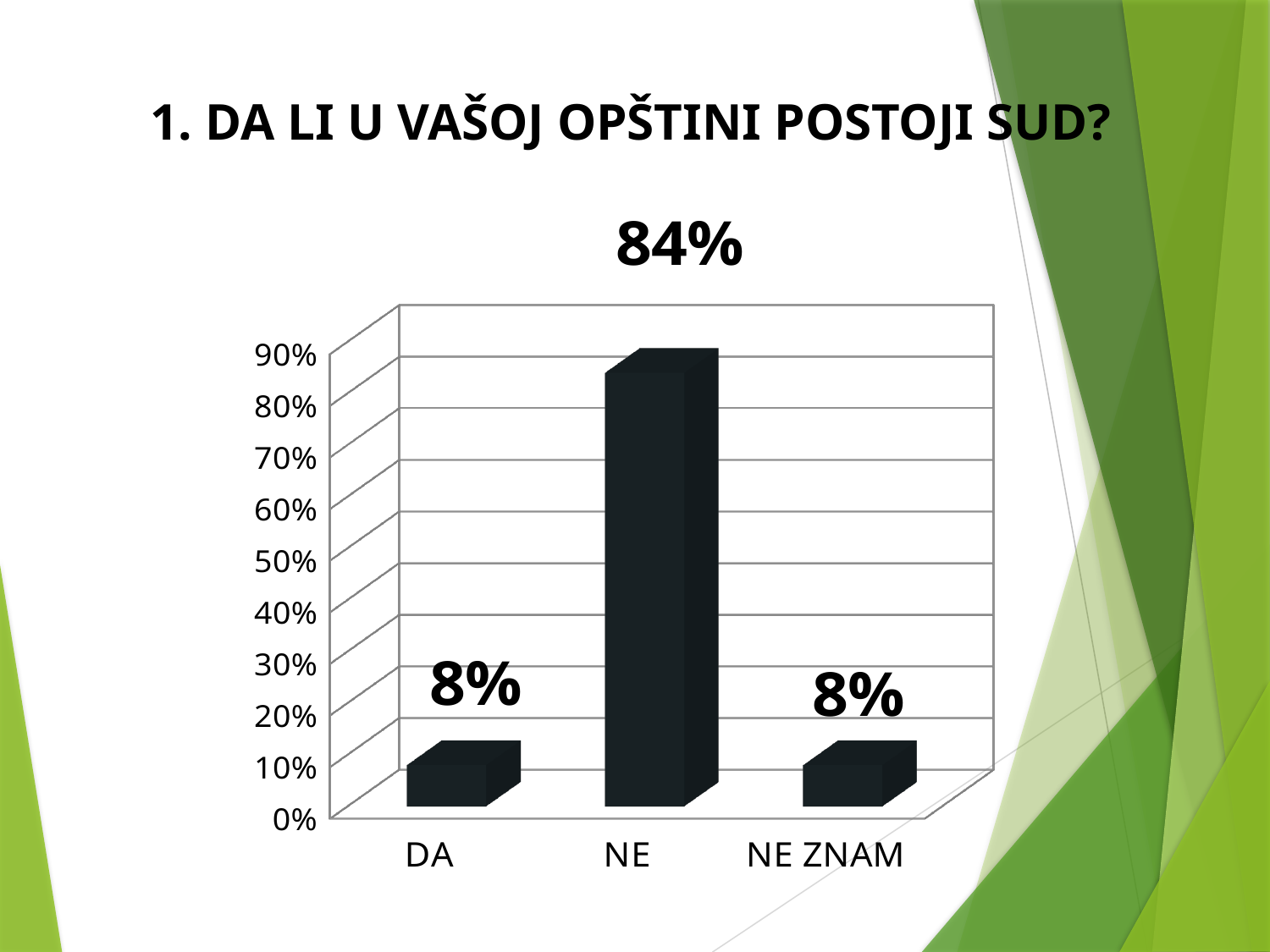
What is the total of the values for DA, NE and NE ZNAM? 100% Which is larger, the value for NE or the value for NE ZNAM? NE What is the difference between the values for NE and DA? 76% Which category has the highest value? NE What is the value for NE ZNAM? 8% Is the value for NE greater or less than 50%? greater What is the title of the slide? 1. DA LI U VAŠOJ OPŠTINI POSTOJI SUD? What is the value for DA? 8% Is the value for DA greater or less than 20%? less How many categories are shown on the x axis? 3 What is the value for NE? 84% What kind of chart is shown on the slide? bar chart